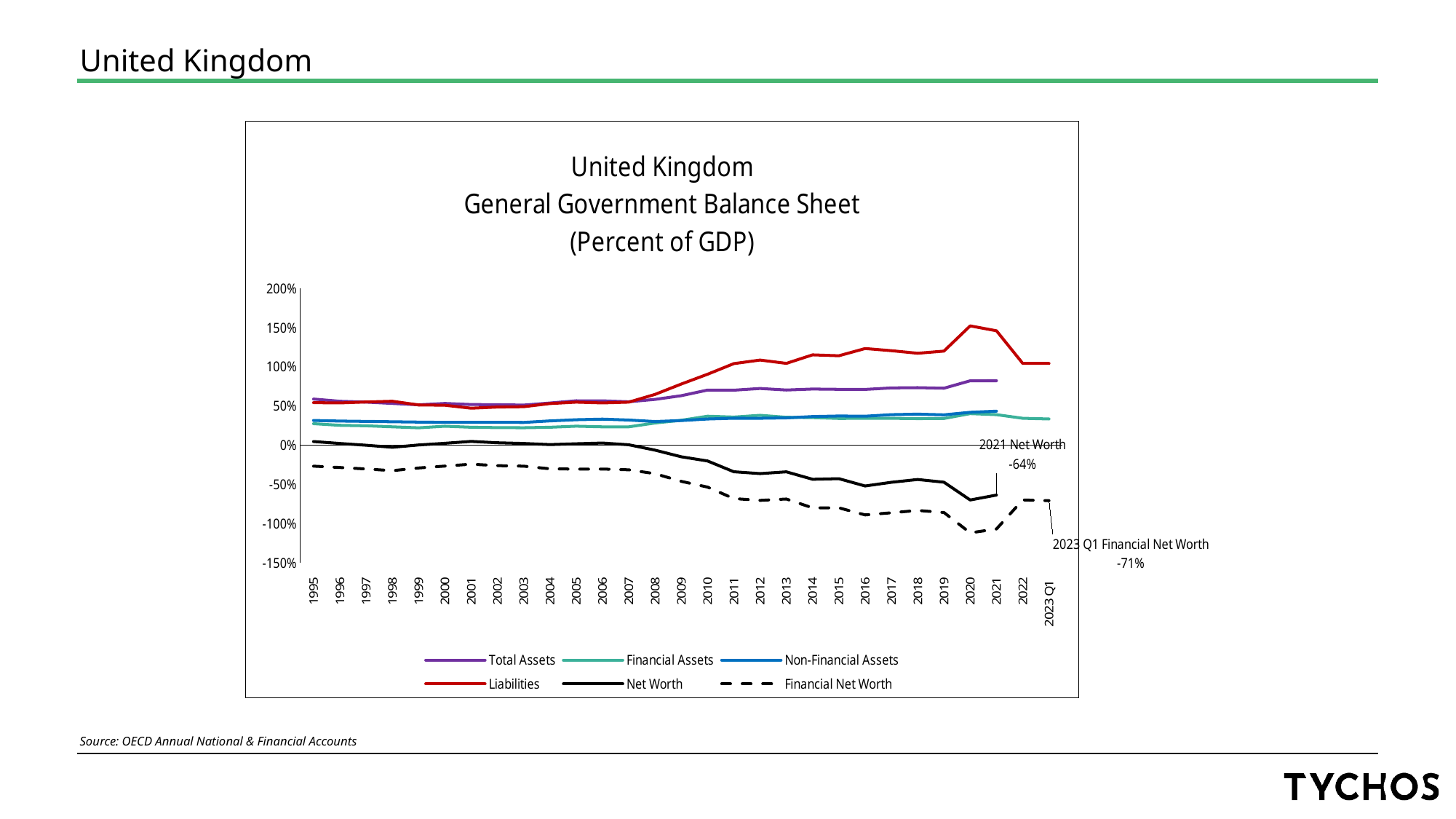
Is the value for Liabilities in 2020 greater or less than 100%? greater Which series has the highest value in 2020? Liabilities In 2020, which is larger: Liabilities or Total Assets? Liabilities What kind of chart is shown on the slide? line chart How many series does the legend list? 6 Do Liabilities rise or fall between 2007 and 2020? rise Is the value for Total Assets in 2021 greater or less than 100%? less What is the Net Worth value labelled for 2021? -64% In what units are the values on the chart expressed, according to the title? Percent of GDP What is the Financial Net Worth value labelled for 2023 Q1? -71% Which series has the lowest value in 2020? Financial Net Worth Is the value for Financial Net Worth in 2020 greater or less than -100%? less